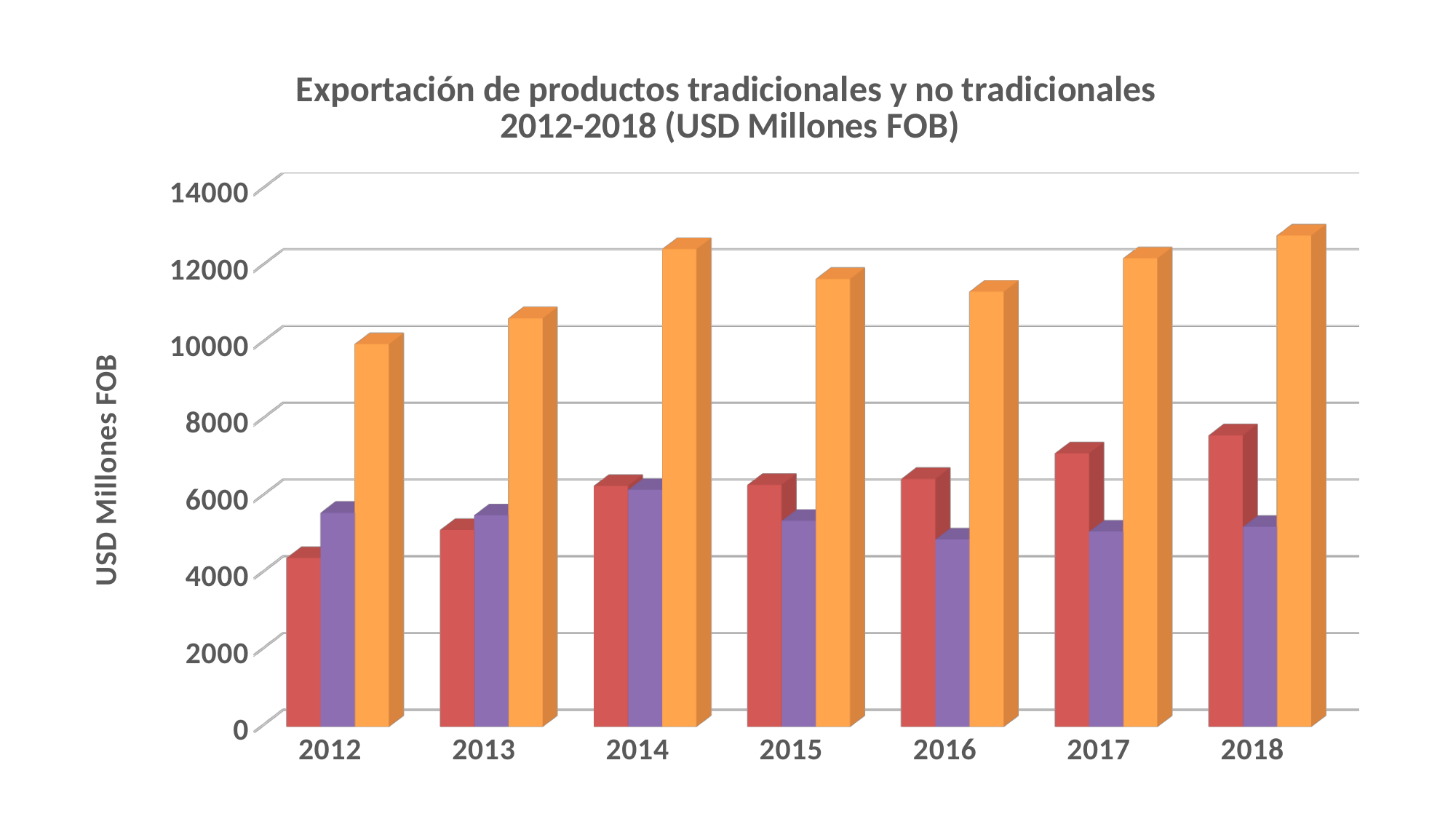
What is the title of the chart? Exportación de productos tradicionales y no tradicionales 2012-2018 (USD Millones FOB) In which year is the orange bar the highest? 2018 What type of chart is shown on the slide? bar chart Is the value of the orange bar for 2014 greater or less than 12000? greater In 2012, which is larger, the red bar or the purple bar? the purple bar How many years are shown on the x axis of the chart? 7 In which year is the red bar the highest? 2018 Does the red series generally rise or fall from 2012 to 2018? rise In which year is the orange bar the lowest? 2012 In which year is the red bar the lowest? 2012 What is the label on the vertical axis of the chart? USD Millones FOB Is the value of the red bar for 2018 greater or less than 8000? less